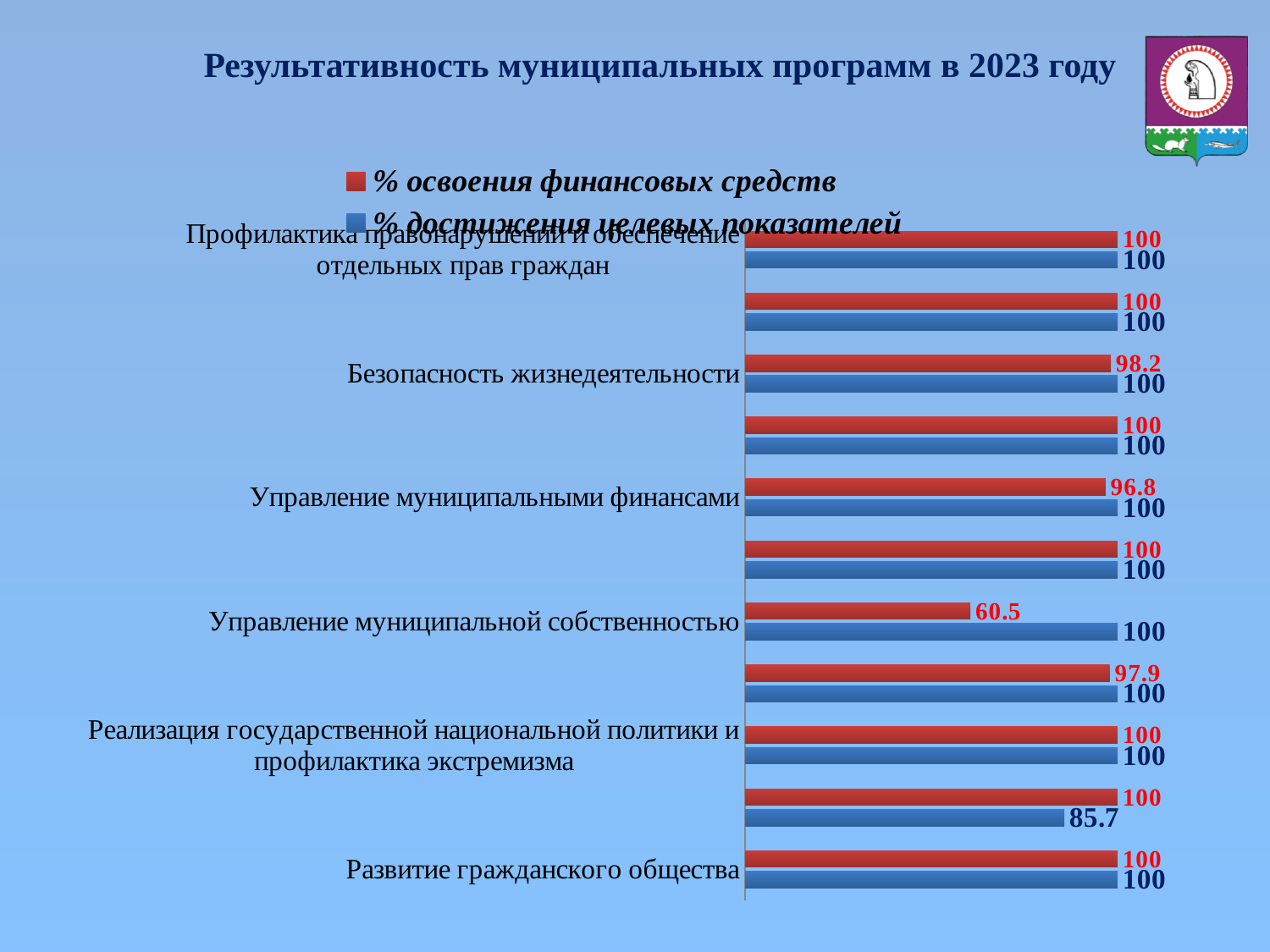
What is the value of % освоения финансовых средств for Управление муниципальными финансами? 96.8 Which labeled category has the lowest value of % освоения финансовых средств? Управление муниципальной собственностью For Безопасность жизнедеятельности, which is larger: % освоения финансовых средств or % достижения целевых показателей? % достижения целевых показателей What is the value of % освоения финансовых средств for Безопасность жизнедеятельности? 98.2 What is the value of % освоения финансовых средств for Развитие гражданского общества? 100 What is the title of the chart? Результативность муниципальных программ в 2023 году What is the value of % освоения финансовых средств for Управление муниципальной собственностью? 60.5 What type of chart is shown on the slide? Bar chart How many series does the legend list? 2 What is the lowest value shown for % достижения целевых показателей? 85.7 What is the value of % достижения целевых показателей for Управление муниципальной собственностью? 100 What is the difference between % достижения целевых показателей and % освоения финансовых средств for Управление муниципальной собственностью? 39.5